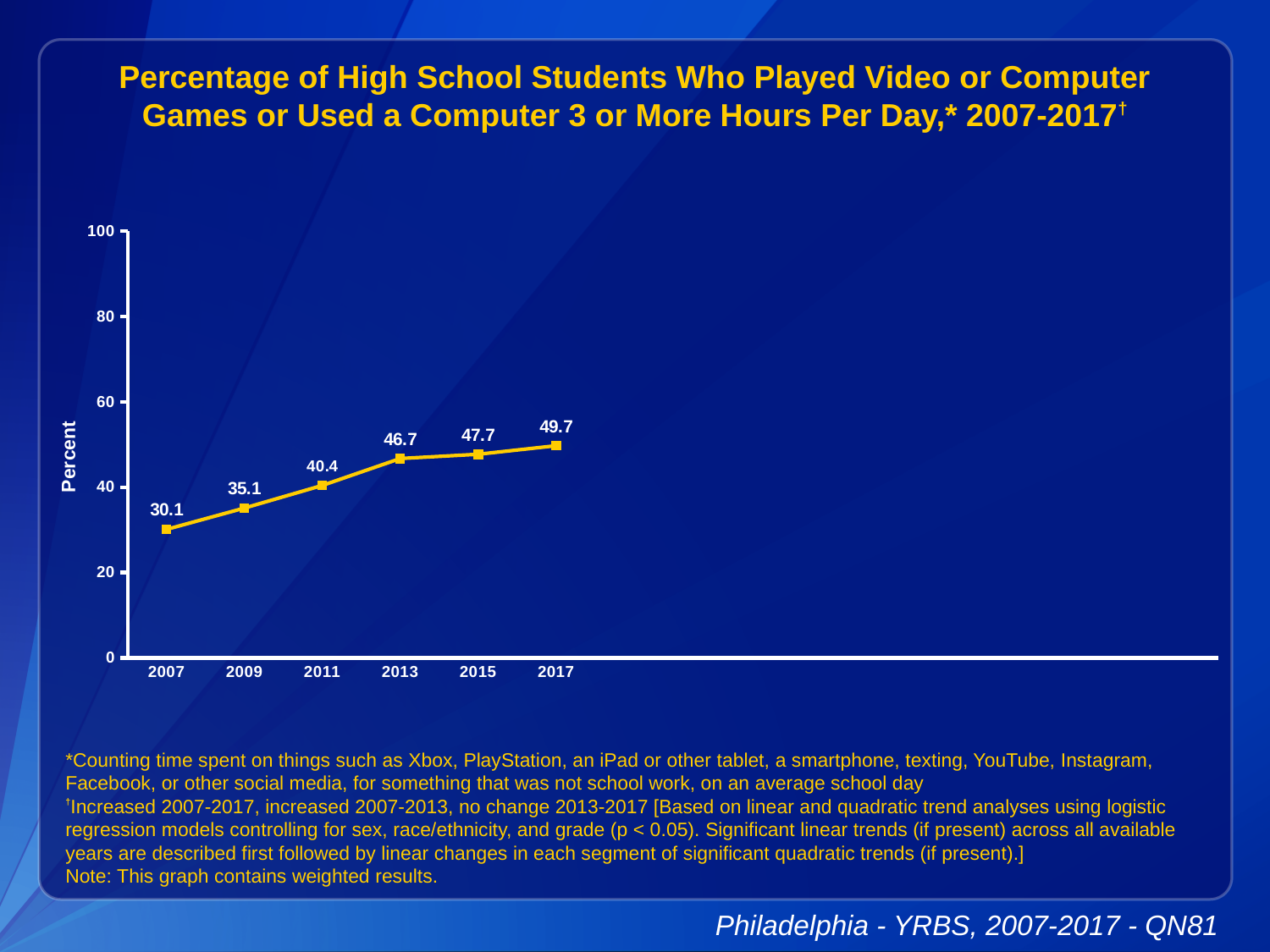
How many years are plotted on the chart? 6 What is the difference between the 2017 value and the 2007 value? 19.6 What is the value plotted for 2013? 46.7 What percentage of high school students played video or computer games or used a computer 3 or more hours per day in 2007? 30.1 Do the values rise or fall from 2007 to 2017? rise Is the value for 2015 greater or less than 40? greater Which year has the highest value on the chart? 2017 Which year has a larger value, 2009 or 2013? 2013 What is the value plotted for 2017? 49.7 What kind of chart is shown on the slide? line chart Which year has the lowest value on the chart? 2007 What is the difference between the 2011 value and the 2009 value? 5.3